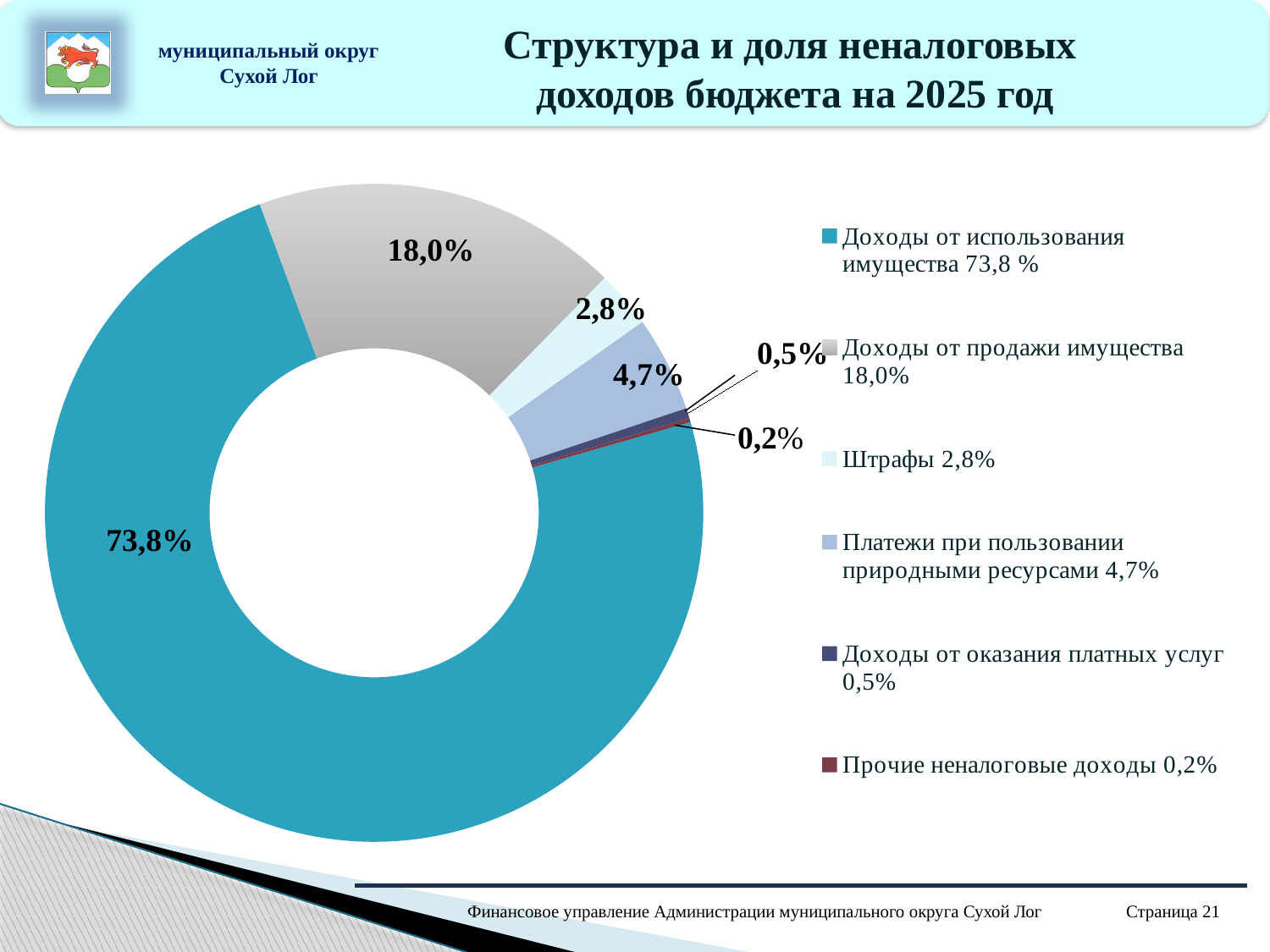
Which is larger: the share for 'Штрафы' or the share for 'Платежи при пользовании природными ресурсами'? Платежи при пользовании природными ресурсами How many categories does the chart show? 6 What kind of chart is shown on the slide? Pie chart (doughnut) What share of non-tax revenues comes from 'Прочие неналоговые доходы'? 0,2% Which category has the largest share of non-tax revenues? Доходы от использования имущества What share of non-tax revenues comes from 'Доходы от продажи имущества'? 18,0% What share of non-tax revenues comes from 'Штрафы'? 2,8% What share of non-tax revenues comes from 'Платежи при пользовании природными ресурсами'? 4,7% What is the title of the slide? Структура и доля неналоговых доходов бюджета на 2025 год What share of non-tax revenues comes from 'Доходы от использования имущества'? 73,8% Which category has the smallest share of non-tax revenues? Прочие неналоговые доходы What is the difference in percentage points between 'Доходы от использования имущества' and 'Доходы от продажи имущества'? 55,8